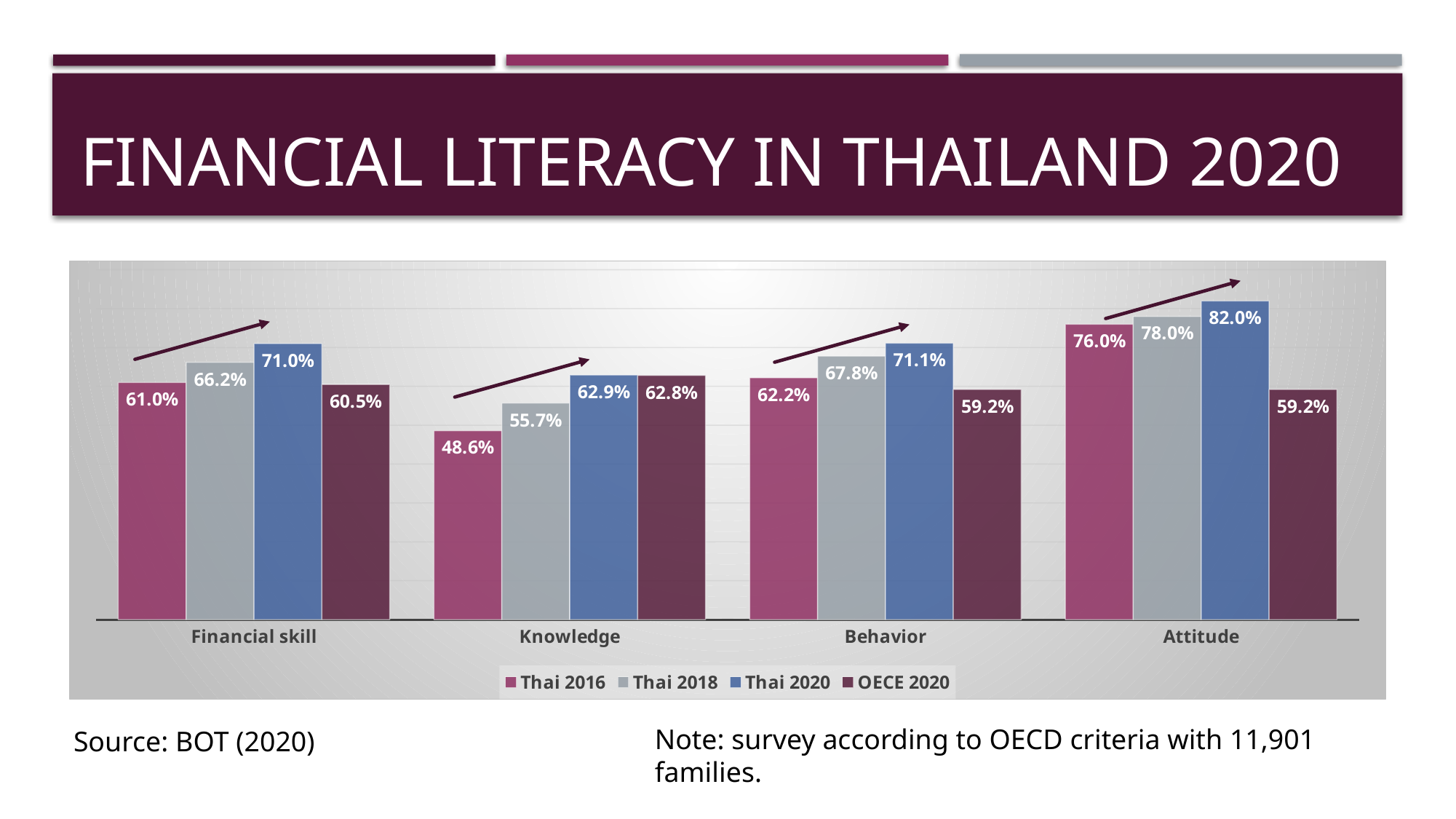
Which category has the lowest Thai 2016 value? Knowledge What is the Thai 2020 value for Knowledge? 62.9% Which category has the highest Thai 2020 value? Attitude What is the Thai 2016 value for Attitude? 76.0% Which is larger for Behavior: the Thai 2020 value or the OECE 2020 value? Thai 2020 What is the difference between the Thai 2020 and Thai 2016 values for Knowledge? 14.3% What kind of chart is shown on the slide? Bar chart What is the Thai 2018 value for Behavior? 67.8% What is the OECE 2020 value for Financial skill? 60.5% How many series does the legend list? 4 How many categories are shown on the x axis? 4 Do the Thai values for Attitude rise or fall from 2016 to 2020? Rise